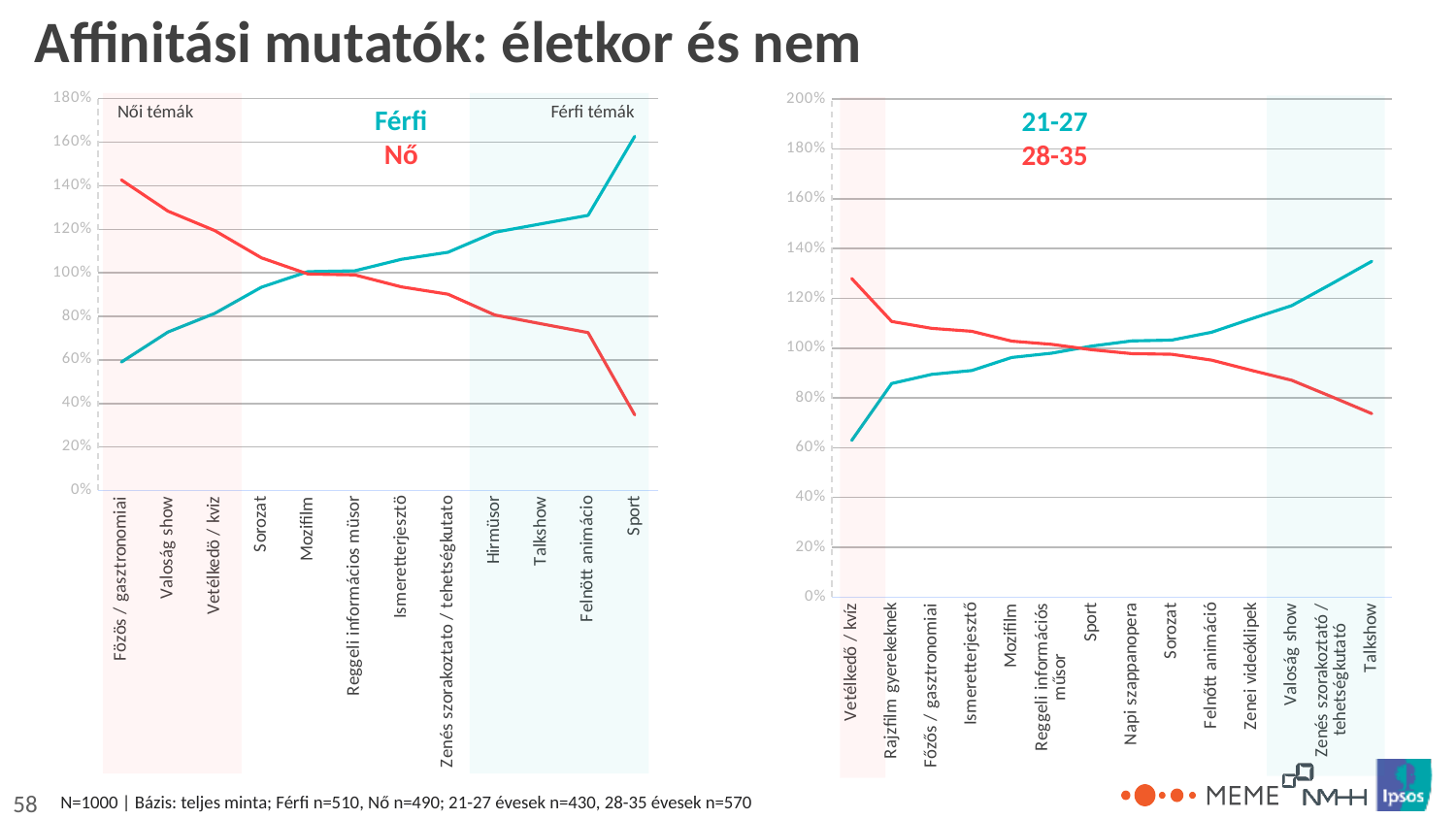
How many categories are shown on the x axis of the right chart (21-27 / 28-35)? 14 In the left chart (Férfi / Nő), which category has the highest value for the Férfi series? Sport What type of chart is the left chart (Férfi / Nő)? line chart In the right chart (21-27 / 28-35), does the 28-35 series rise or fall along the x axis? fall In the left chart (Férfi / Nő), does the Férfi series rise or fall along the x axis? rise In the right chart (21-27 / 28-35), which category has the highest value for the 21-27 series? Talkshow How many categories are shown on the x axis of the left chart (Férfi / Nő)? 12 In the left chart (Férfi / Nő), which category has the lowest value for the Nő series? Sport In the left chart (Férfi / Nő), is the Férfi value for Főzős / gasztronomiai greater or less than 80%? less How many series does the legend of the left chart (Férfi / Nő) list? 2 In the right chart (21-27 / 28-35), is the 21-27 value for Vetélkedő / kvíz greater or less than 80%? less In the left chart (Férfi / Nő), which series has the larger value for Sport, Férfi or Nő? Férfi